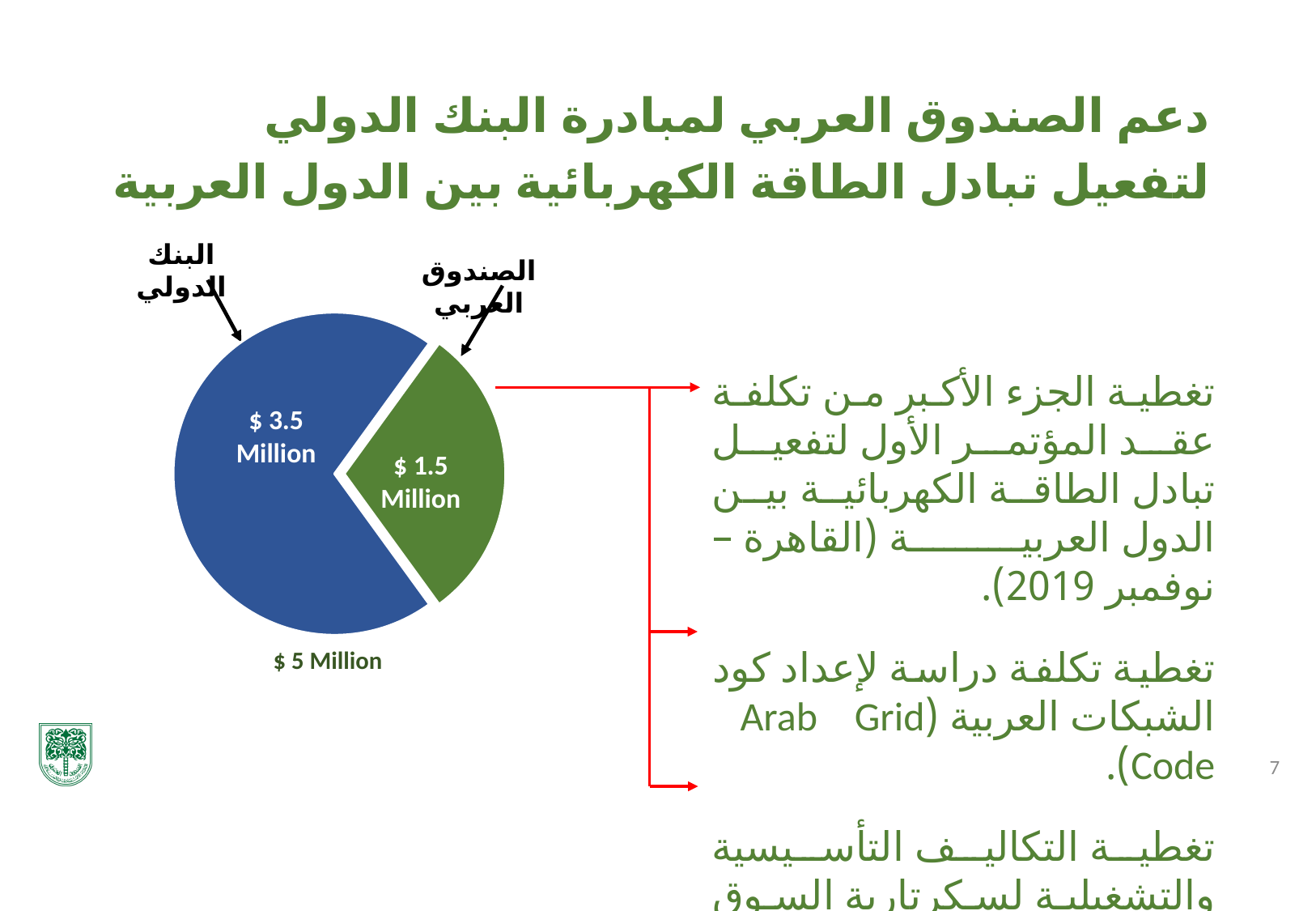
What is the value of the slice labelled الصندوق العربي (Arab Fund)? $ 1.5 Million Which slice is the smallest in the pie chart? الصندوق العربي (Arab Fund) Which slice is the largest in the pie chart? البنك الدولي (World Bank) What kind of chart is shown on the slide? pie chart What share of the total does the Arab Fund slice represent? 30% What colour is the slice for الصندوق العربي (Arab Fund)? green What is the total shown below the pie chart? $ 5 Million What is the difference between the World Bank slice and the Arab Fund slice? $ 2 Million Which is larger, the World Bank contribution or the Arab Fund contribution? World Bank (البنك الدولي) What share of the total does the World Bank slice represent? 70% How many slices does the pie chart have? 2 What is the value of the slice labelled البنك الدولي (World Bank)? $ 3.5 Million